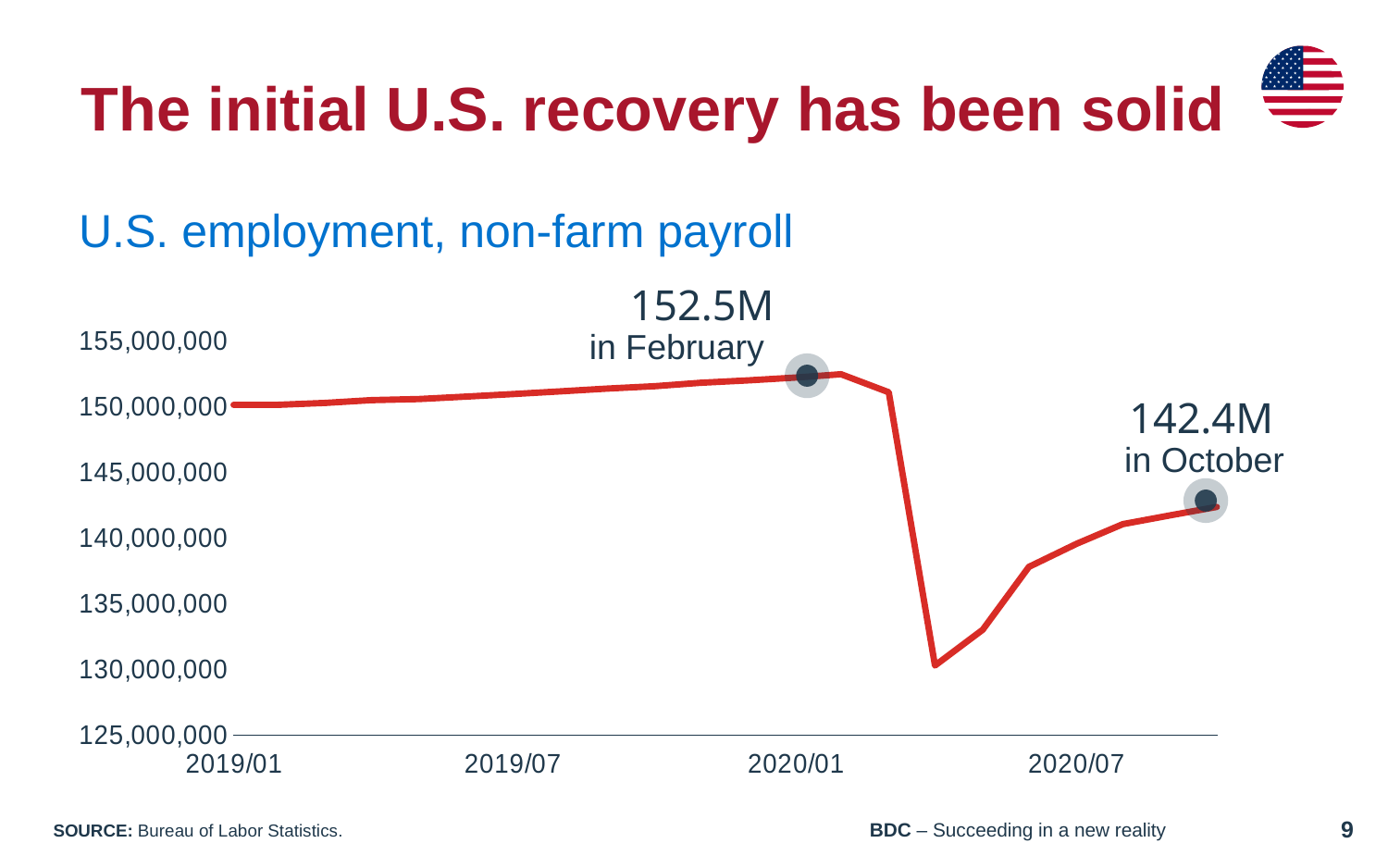
What was U.S. non-farm payroll employment in February 2020, according to the annotation? 152.5M What was U.S. non-farm payroll employment in October 2020, according to the annotation? 142.4M What is the title of the chart? U.S. employment, non-farm payroll Is the lowest point of the line, in spring 2020, greater or less than 135,000,000? less What type of chart is shown on the slide? line chart Is the value at the start of the line in 2019/01 greater or less than 145,000,000? greater Does the line rise or fall between 2019/01 and February 2020? rise What source is cited for the chart data? Bureau of Labor Statistics Which is larger, the annotated value for February or the annotated value for October? February Does the line rise or fall between its spring 2020 low point and October 2020? rise What is the difference between the annotated February value (152.5M) and the annotated October value (142.4M)? 10.1M How many date labels are shown on the x axis? 4